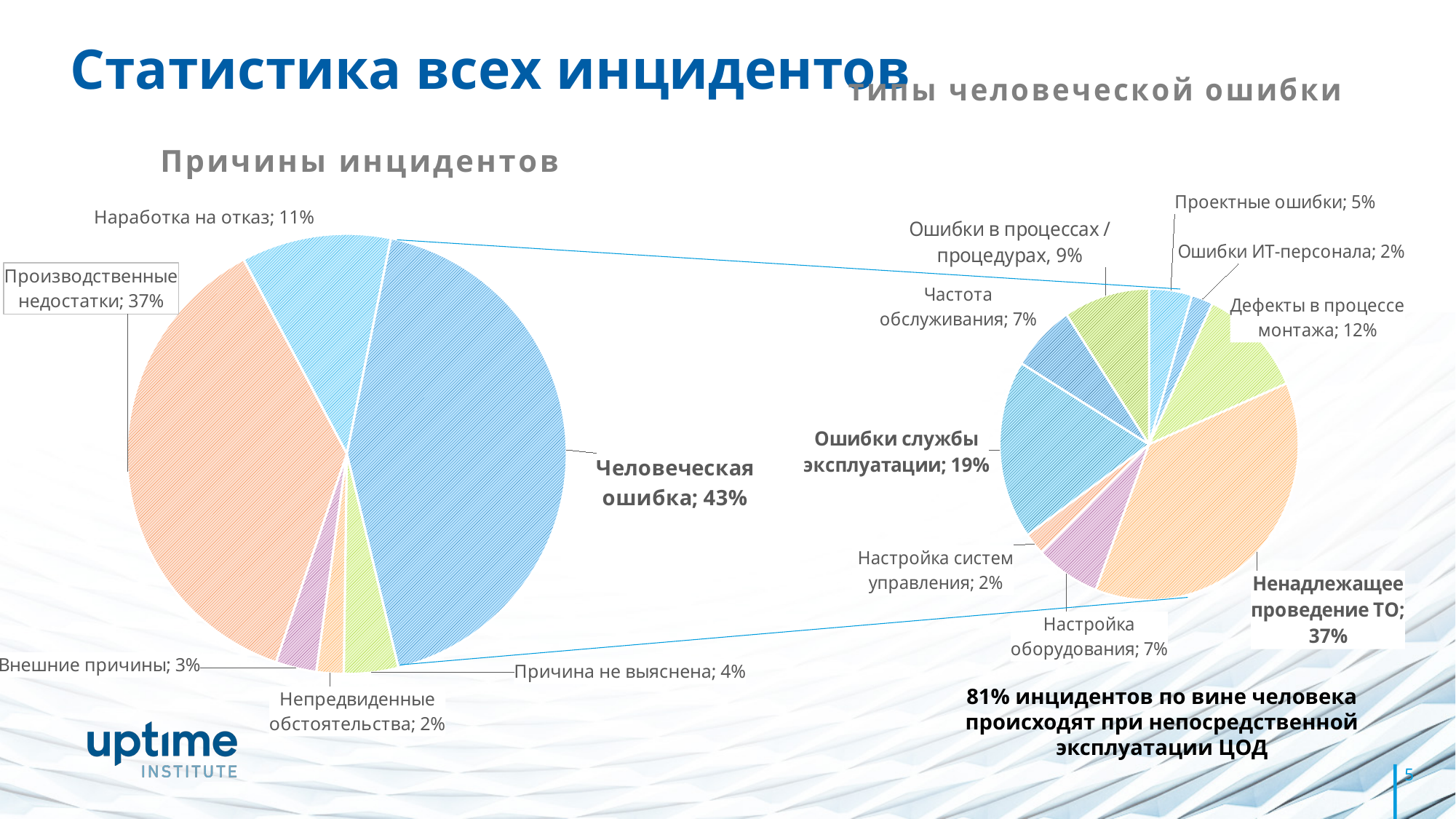
How many slices does the 'Причины инцидентов' pie chart have? 6 In the 'Причины инцидентов' pie chart, what is the difference between 'Человеческая ошибка' and 'Производственные недостатки'? 6% In the 'Причины инцидентов' pie chart, what share is labelled for 'Человеческая ошибка'? 43% What type of chart is used for 'Причины инцидентов'? Pie chart In the 'Типы человеческой ошибки' pie chart, which is larger: 'Ошибки службы эксплуатации' or 'Ошибки в процессах / процедурах'? Ошибки службы эксплуатации In the 'Типы человеческой ошибки' pie chart, what is the difference between 'Ненадлежащее проведение ТО' and 'Ошибки службы эксплуатации'? 18% In the 'Причины инцидентов' pie chart, which category has the smallest share? Непредвиденные обстоятельства In the 'Причины инцидентов' pie chart, what is the value for 'Наработка на отказ'? 11% In the 'Типы человеческой ошибки' pie chart, what is the value for 'Ненадлежащее проведение ТО'? 37% How many slices does the 'Типы человеческой ошибки' pie chart have? 9 In the 'Причины инцидентов' pie chart, which category has the largest share? Человеческая ошибка In the 'Типы человеческой ошибки' pie chart, what is the value for 'Дефекты в процессе монтажа'? 12%